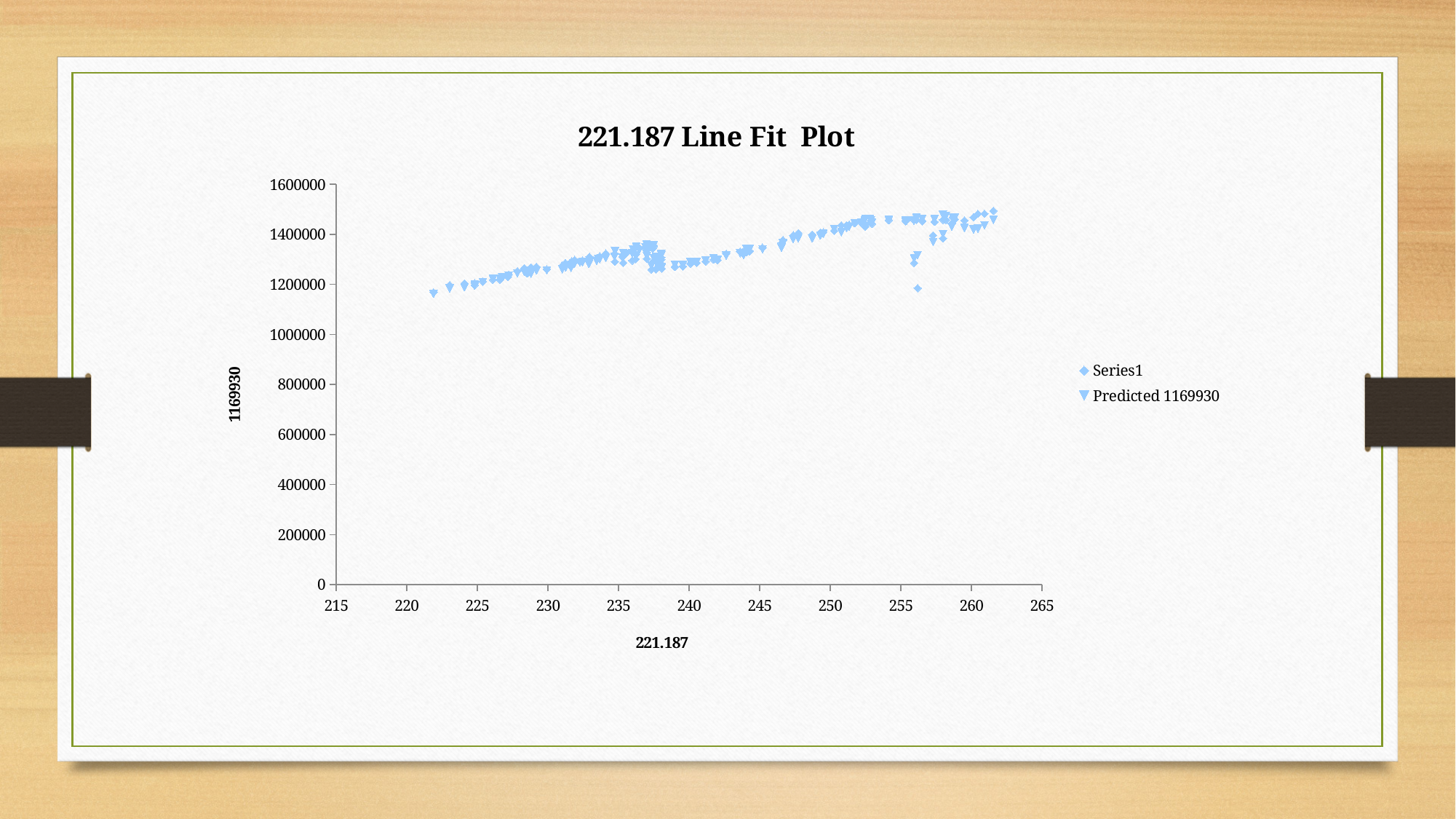
What are the two series named in the legend? Series1 and Predicted 1169930 Is the lowest plotted value on the chart greater or less than 1000000? greater What is the title of the chart? 221.187 Line Fit Plot Are the plotted values near x = 260 greater or less than 1200000? greater How many series does the legend list? 2 Are the plotted values near x = 222 greater or less than 1400000? less Do the plotted values generally rise or fall as the x-axis value increases from 220 to 260? Rise What kind of chart is shown on the slide? Scatter plot Which is larger: the plotted values near x = 250 or the plotted values near x = 225? Near x = 250